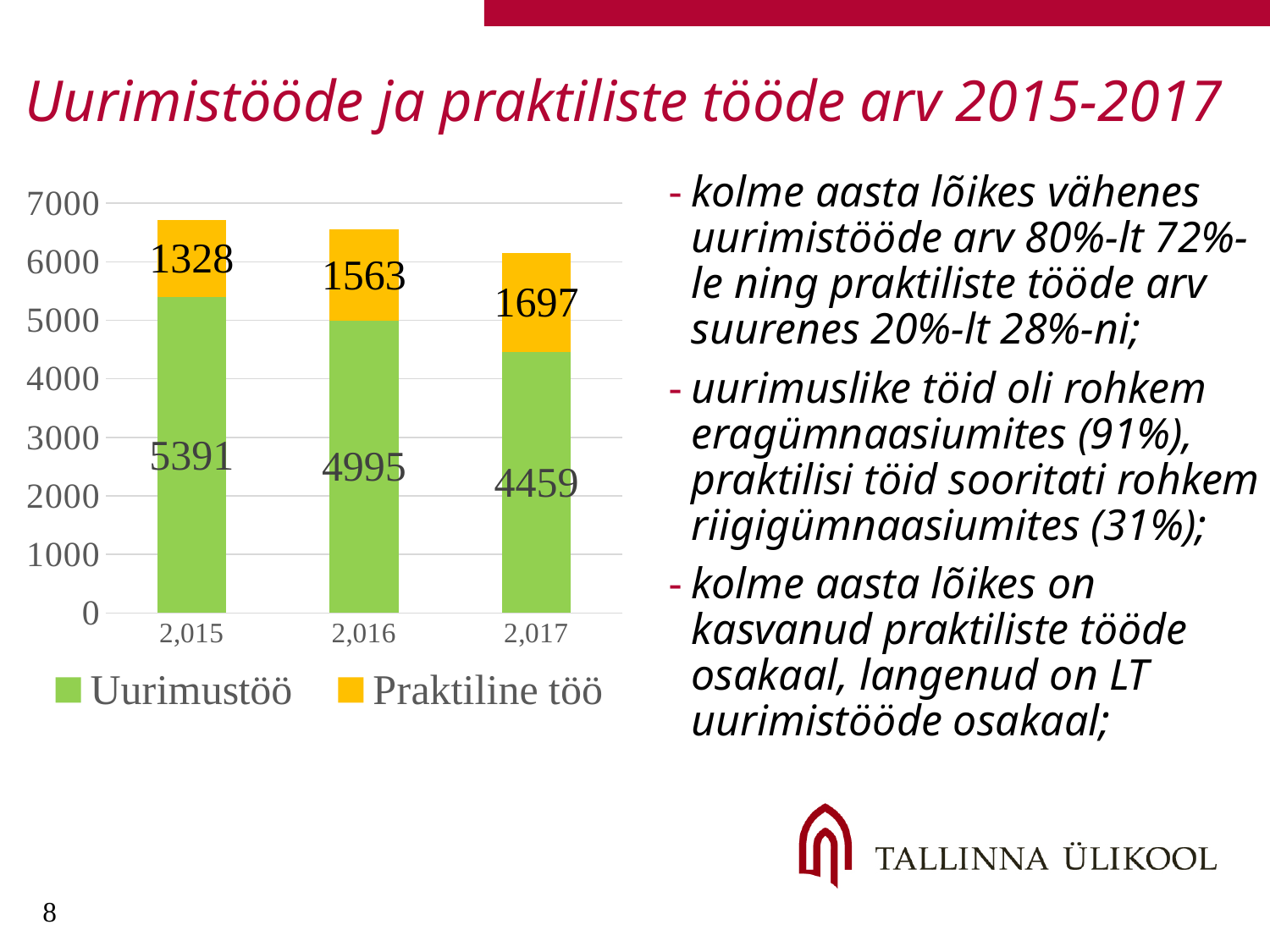
In which year is the Uurimustöö value the lowest? 2017 What is the value of Praktiline töö for 2017? 1697 What is the difference between the Uurimustöö values for 2015 and 2017? 932 What is the value of Uurimustöö for 2015? 5391 What is the total of the stacked bar for 2017? 6156 Does the Uurimustöö value rise or fall from 2015 to 2017? fall In which year is the Praktiline töö value the highest? 2017 Which is larger, the Praktiline töö value for 2015 or for 2016? 2016 What is the total of the stacked bar for 2015? 6719 What is the value of Uurimustöö for 2017? 4459 How many series does the legend list? 2 What is the value of Praktiline töö for 2016? 1563